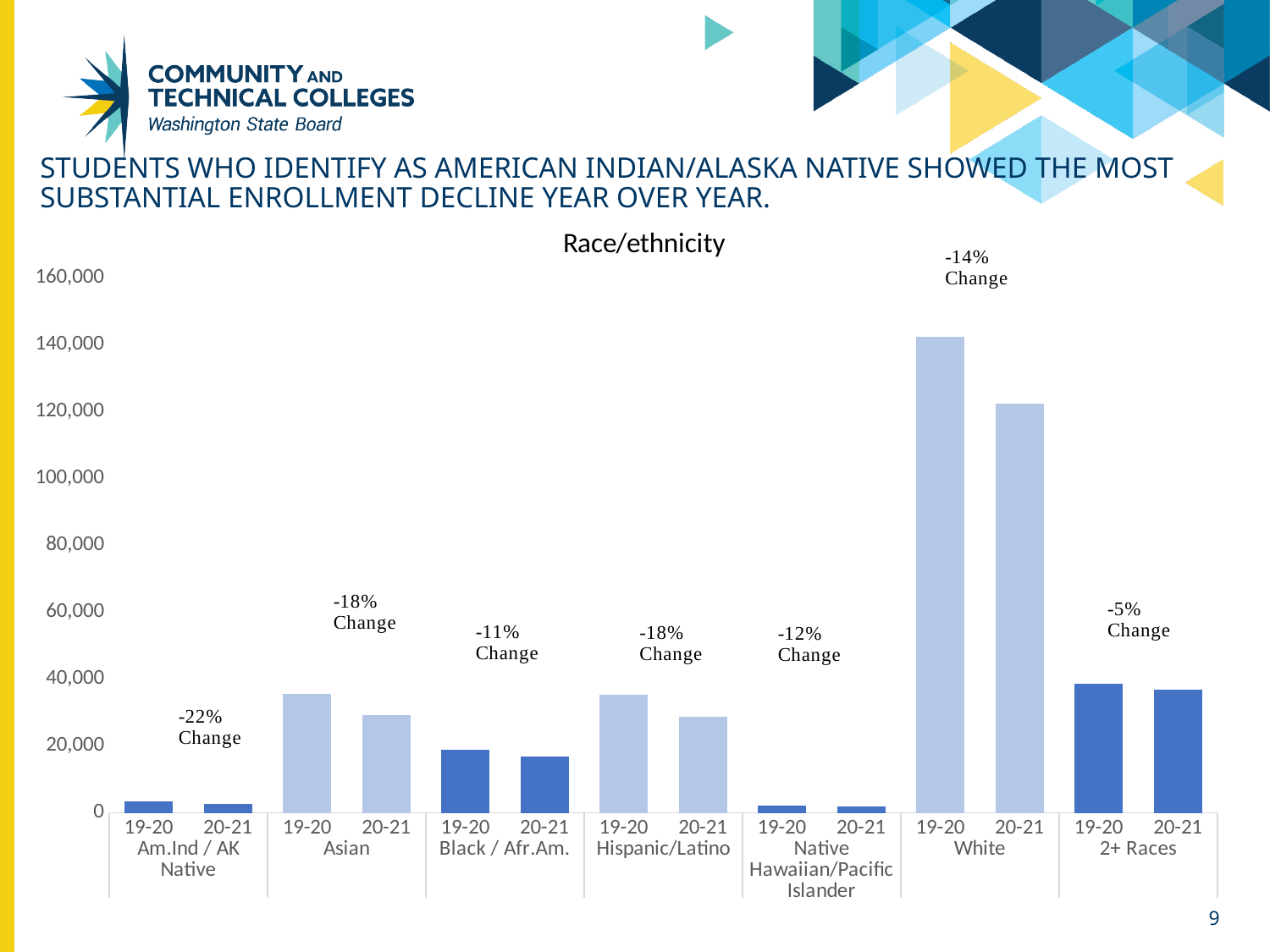
Which race/ethnicity group has the tallest bar in the chart? White Is the 20-21 value for Hispanic/Latino greater or less than 20,000? greater How many race/ethnicity groups are shown on the x axis of the chart? 7 What percent change is annotated for the Asian group? -18% Change Within each race/ethnicity group, does the value rise or fall from 19-20 to 20-21? fall Which group shows the smallest percent change according to the annotations? 2+ Races What is the title of the chart? Race/ethnicity What percent change is annotated for the 2+ Races group? -5% Change Which is larger, the 19-20 value for White or the 19-20 value for Asian? White What type of chart is shown on the slide? bar chart Is the 19-20 value for Asian greater or less than 40,000? less What percent change is annotated for the Am.Ind / AK Native group? -22% Change